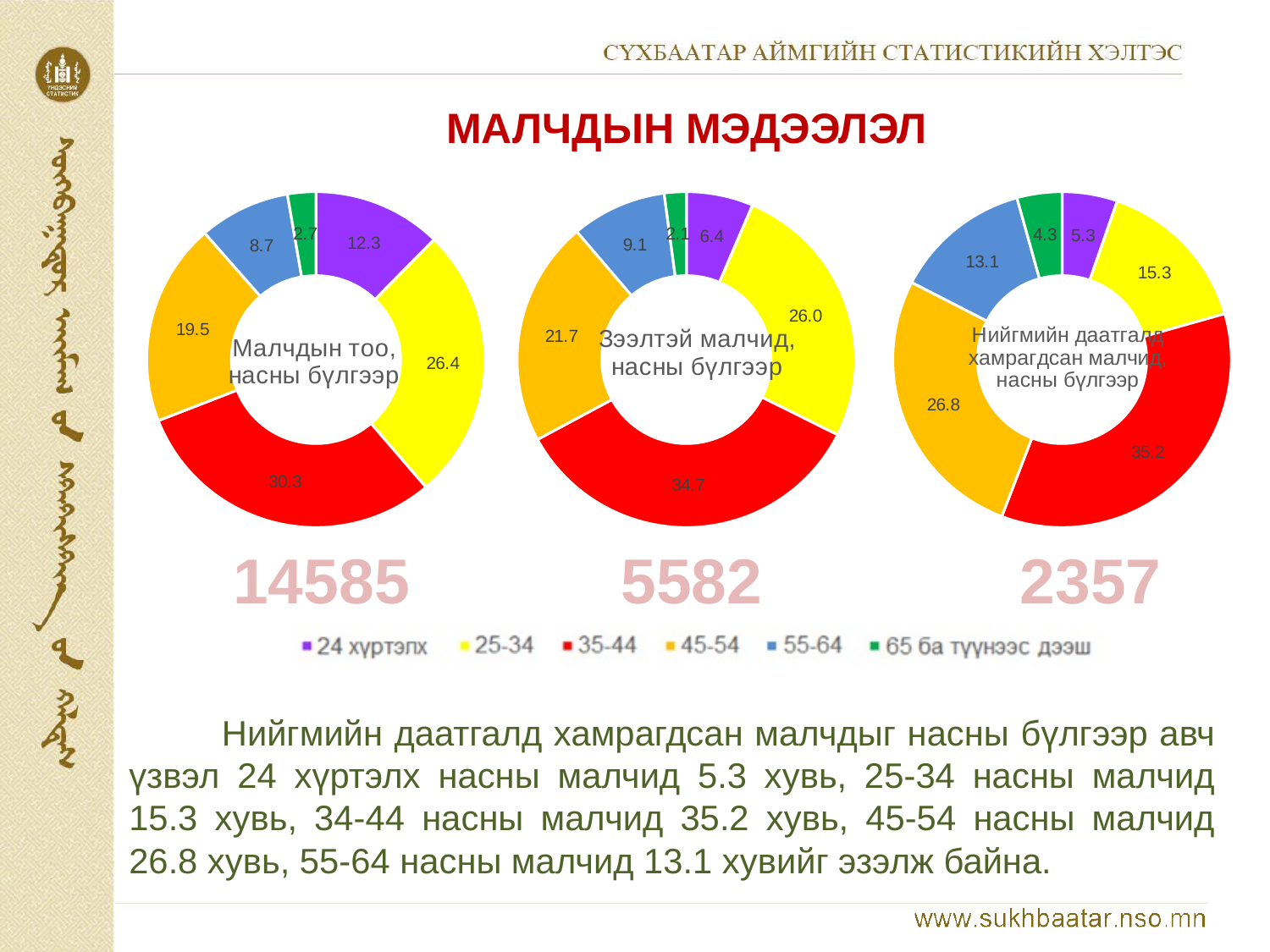
What kind of chart is used on this slide? Doughnut chart In the left chart (Малчдын тоо, насны бүлгээр), what is the difference between the 25-34 and 45-54 values? 6.9 In the left chart (Малчдын тоо, насны бүлгээр), what is the value for the 35-44 age group? 30.3 What colour represents the 35-44 age group in the legend? Red How many charts are shown on the slide? 3 In the right chart (Нийгмийн даатгалд хамрагдсан малчид, насны бүлгээр), which age group has the largest share? 35-44 In the right chart (Нийгмийн даатгалд хамрагдсан малчид, насны бүлгээр), what is the value for the 55-64 age group? 13.1 In the middle chart (Зээлтэй малчид, насны бүлгээр), which age group has the smallest share? 65 ба түүнээс дээш How many age groups does the legend list? 6 In the left chart (Малчдын тоо, насны бүлгээр), which is larger: the value for 24 хүртэлх or the value for 55-64? 24 хүртэлх In the middle chart (Зээлтэй малчид, насны бүлгээр), what is the value for the 45-54 age group? 21.7 What is the total number shown below the middle chart (Зээлтэй малчид, насны бүлгээр)? 5582